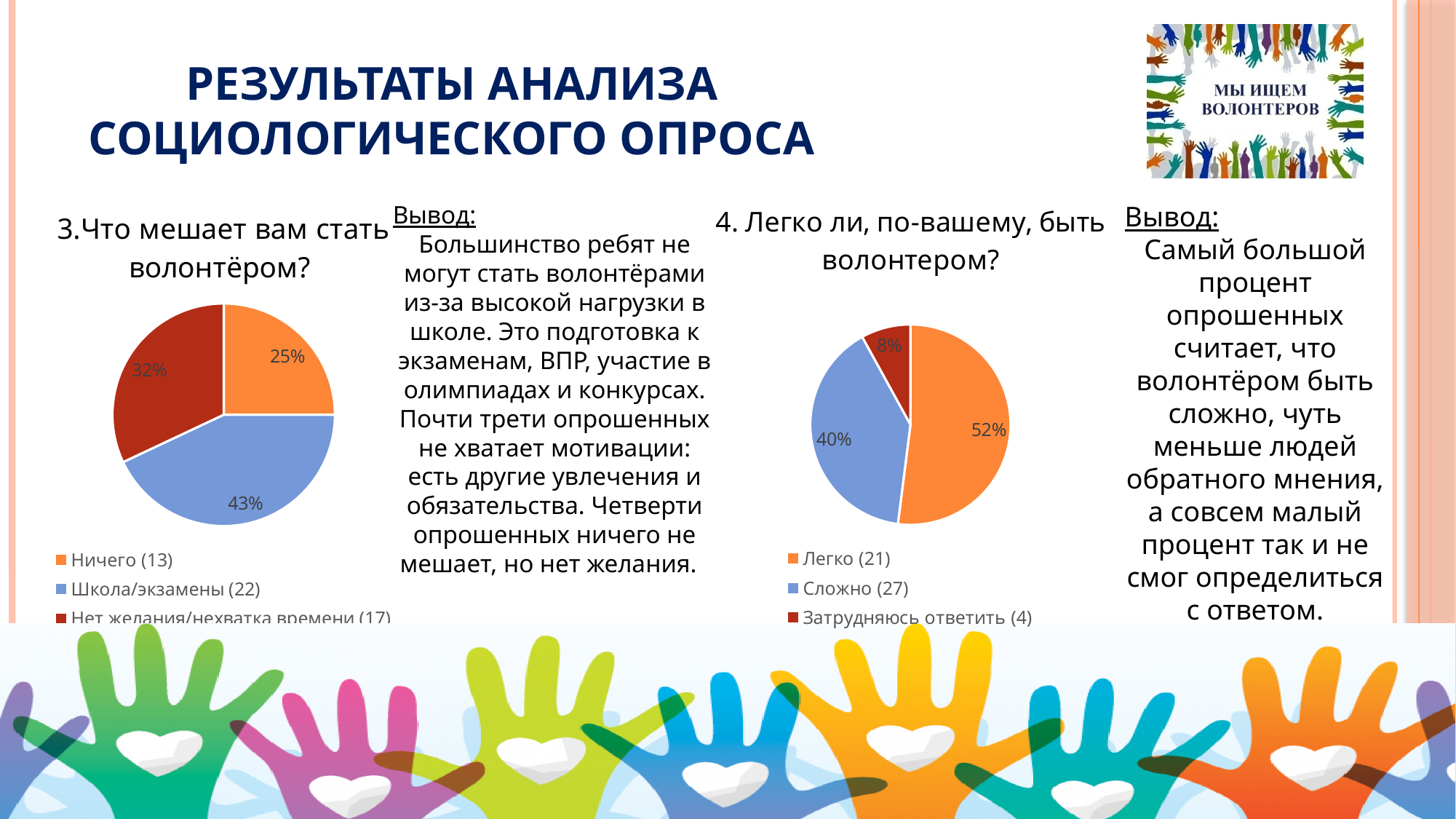
In the right pie chart "Легко ли, по-вашему, быть волонтером?", what is the difference in percentage points between the blue slice (40%) and the red slice (8%)? 32 In the left pie chart "Что мешает вам стать волонтёром?", what colour is the "Нет желания/нехватка времени" slice? Red In the right pie chart "Легко ли, по-вашему, быть волонтером?", what percentage is shown for the "Затрудняюсь ответить" slice? 8% In the right pie chart "Легко ли, по-вашему, быть волонтером?", what percentage is shown on the orange slice ("Легко")? 52% What type of chart is used for "Легко ли, по-вашему, быть волонтером?" on the right? Pie chart In the left pie chart "Что мешает вам стать волонтёром?", what percentage is shown for the "Ничего" slice? 25% How many categories does the legend of the left pie chart "Что мешает вам стать волонтёром?" list? 3 In the left pie chart "Что мешает вам стать волонтёром?", what percentage is shown for the "Школа/экзамены" slice? 43% In the left pie chart "Что мешает вам стать волонтёром?", what is the difference in percentage points between the "Школа/экзамены" slice and the "Нет желания/нехватка времени" slice? 11 In the left pie chart "Что мешает вам стать волонтёром?", which category has the smallest slice? Ничего In the right pie chart "Легко ли, по-вашему, быть волонтером?", which category has the smallest slice? Затрудняюсь ответить In the left pie chart "Что мешает вам стать волонтёром?", which category has the largest slice? Школа/экзамены